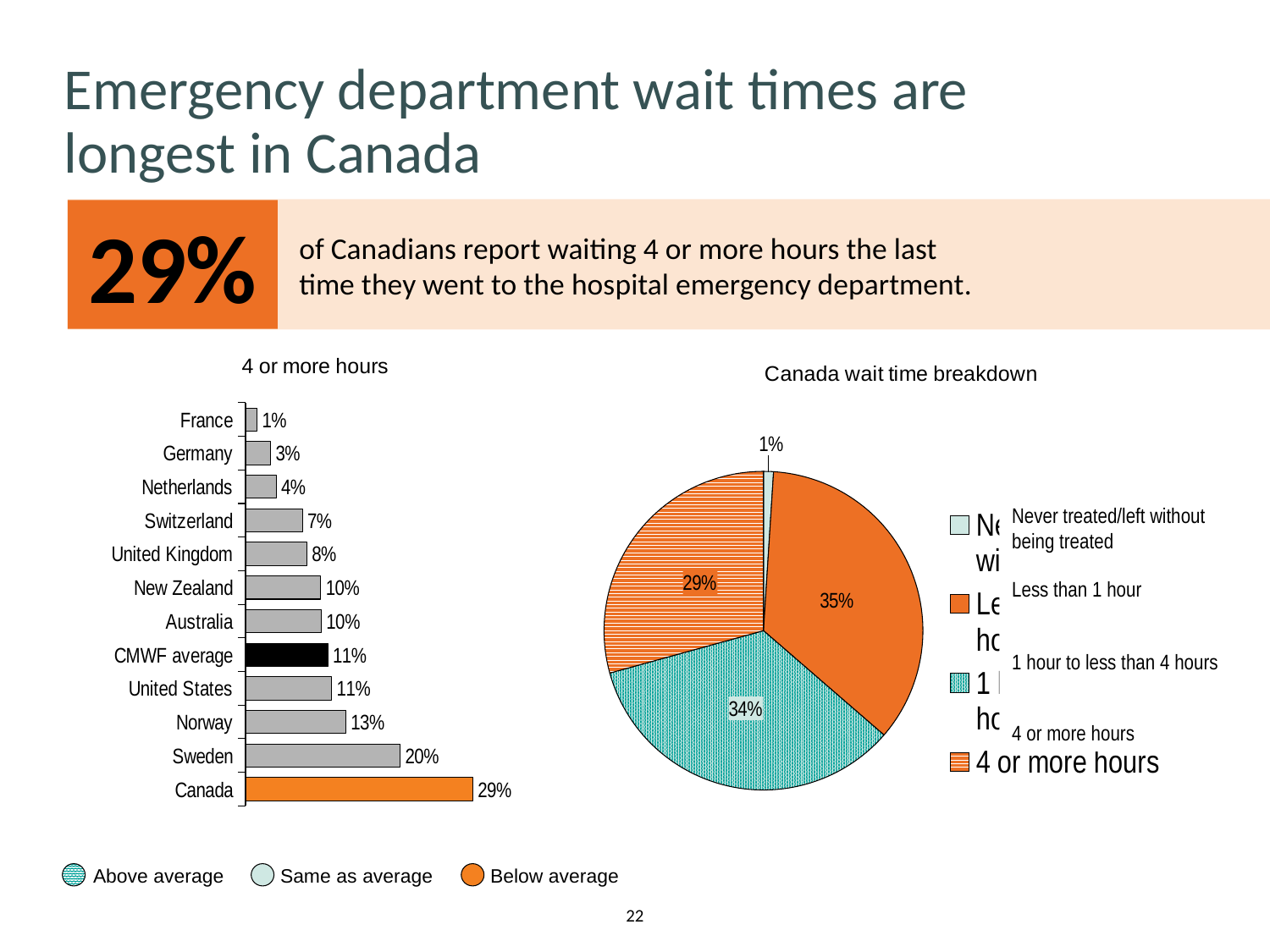
In the 'Canada wait time breakdown' pie chart, what share is '1 hour to less than 4 hours'? 34% In the '4 or more hours' bar chart, what is the value for Sweden? 20% In the '4 or more hours' bar chart, which is larger, Norway or the United Kingdom? Norway In the 'Canada wait time breakdown' pie chart, what share is 'Less than 1 hour'? 35% What type of chart is the '4 or more hours' chart? Bar chart How many slices does the 'Canada wait time breakdown' pie chart have? 4 In the '4 or more hours' bar chart, what is the difference between Canada and Sweden? 9% In the '4 or more hours' bar chart, what is the value for the CMWF average? 11% In the '4 or more hours' bar chart, which country has the highest value? Canada How many categories are shown in the '4 or more hours' bar chart? 12 In the 'Canada wait time breakdown' pie chart, which slice is the smallest? Never treated/left without being treated In the '4 or more hours' bar chart, which country has the lowest value? France